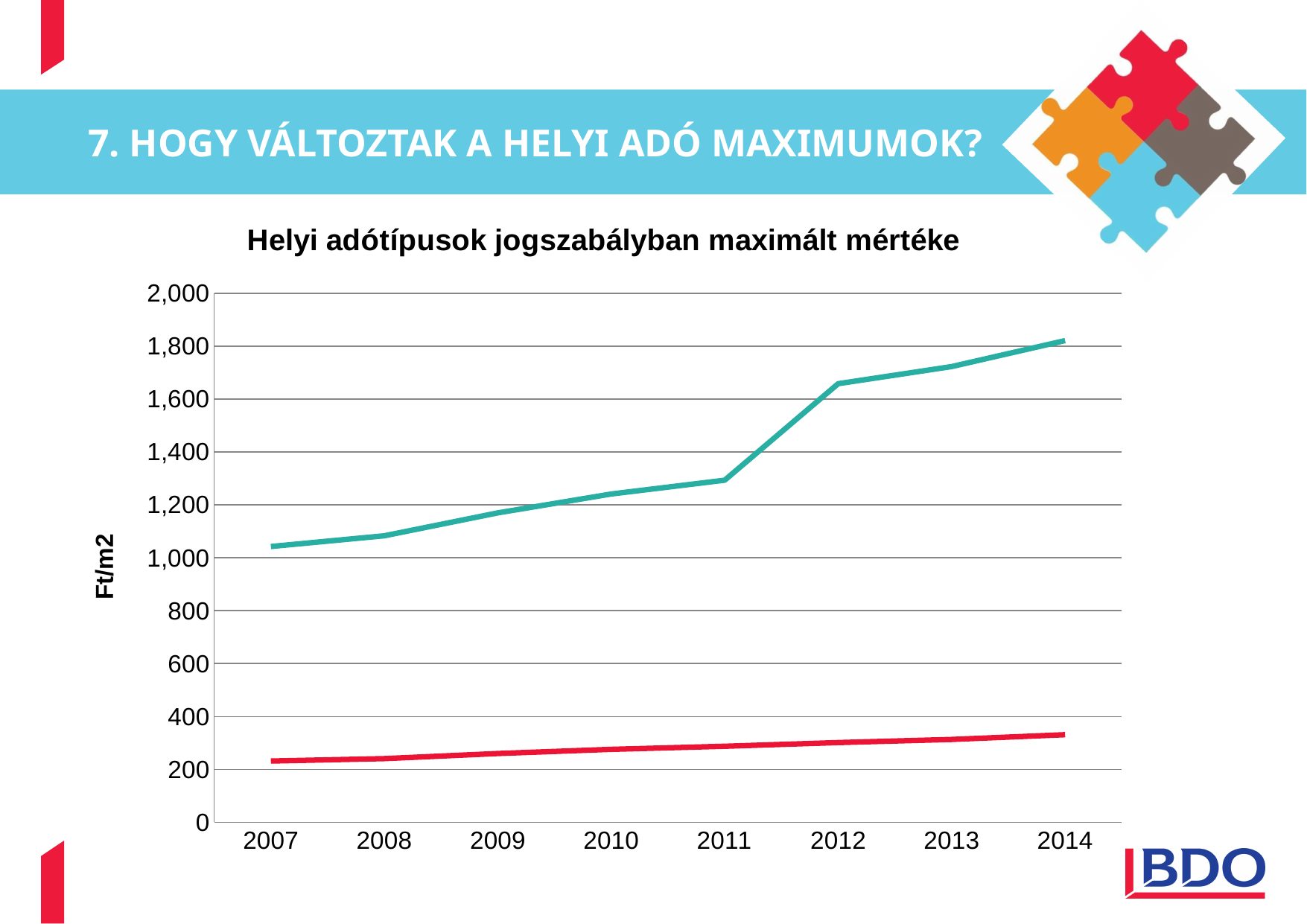
What is the label on the vertical axis of the chart? Ft/m2 Does the red line rise or fall from 2007 to 2014? rise What is the title of the chart? Helyi adótípusok jogszabályban maximált mértéke Is the value of the teal line in 2011 greater or less than 1,400? less In which year does the teal line reach its highest value? 2014 In 2014, which line has the larger value, the teal line or the red line? the teal line How many years are plotted along the x axis of the chart? 8 In which year does the teal line have its lowest value? 2007 Is the value of the red line in 2014 greater or less than 400? less Does the teal line rise or fall from 2007 to 2014? rise Is the value of the teal line in 2014 greater or less than 2,000? less What kind of chart is shown on the slide? line chart